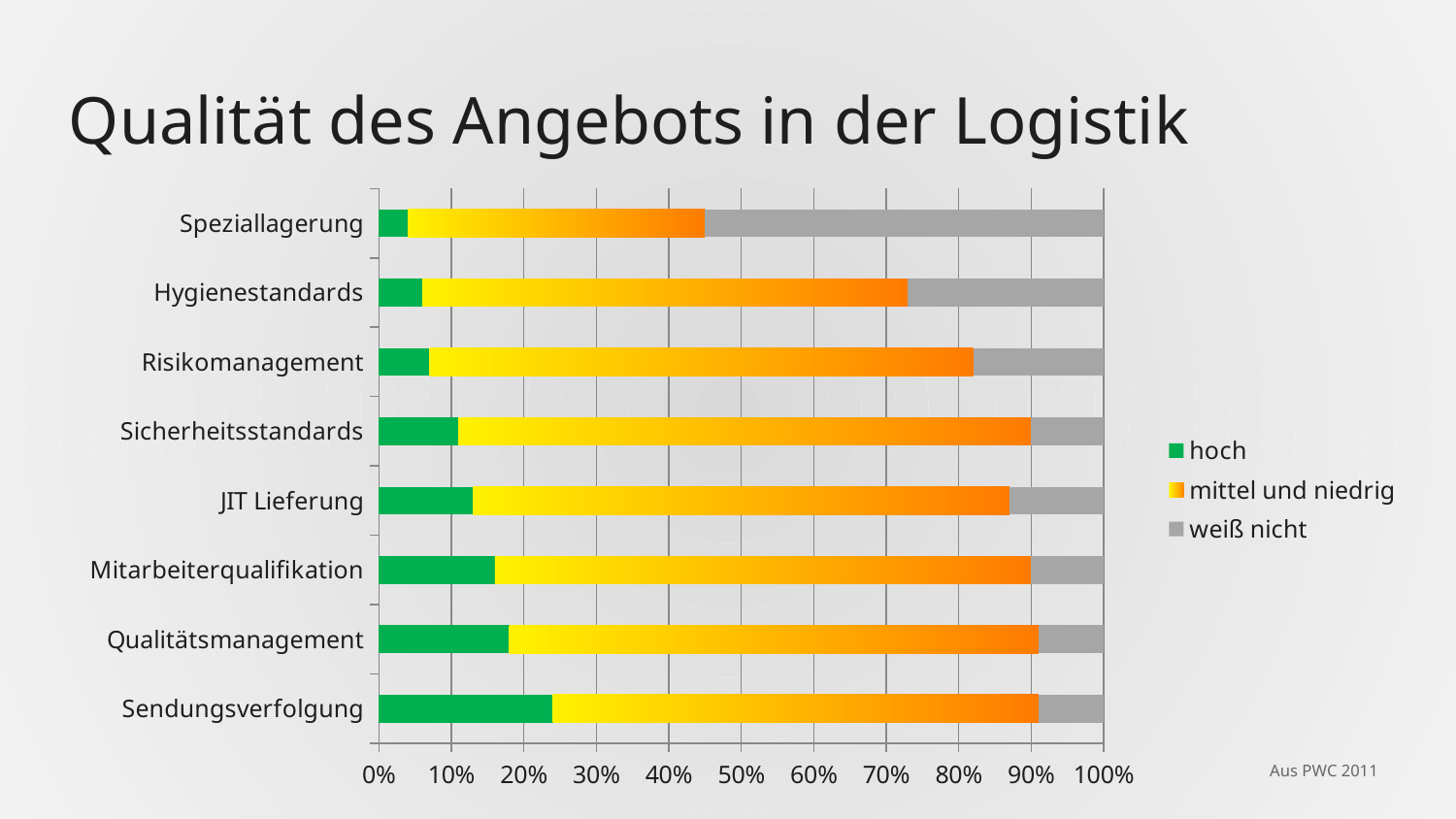
Which category has the smallest 'hoch' share? Speziallagerung Is the 'hoch' value for Sendungsverfolgung greater or less than 20%? greater What is the total of the stacked bar for Risikomanagement? 100% How many categories are shown on the vertical axis? 8 Which category has the largest 'hoch' share? Sendungsverfolgung What kind of chart is shown on the slide? stacked bar chart How many series does the legend list? 3 Is the 'hoch' value for Speziallagerung greater or less than 10%? less Which has a larger 'hoch' share, Qualitätsmanagement or Hygienestandards? Qualitätsmanagement Is the 'weiß nicht' value for Speziallagerung greater or less than 50%? greater What is the title of the chart? Qualität des Angebots in der Logistik Which category has the largest 'weiß nicht' share? Speziallagerung